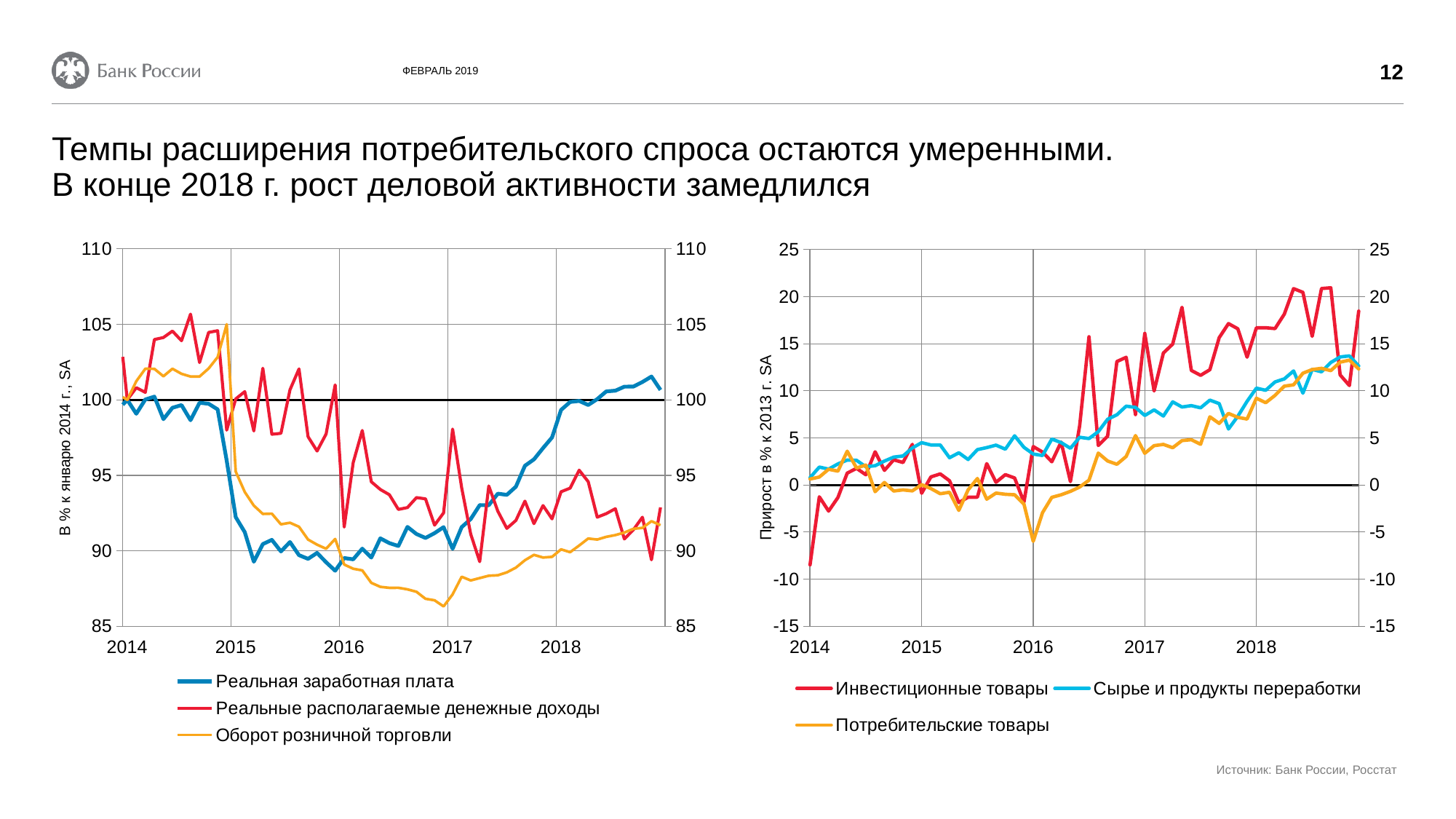
In the right chart, is the value for Сырье и продукты переработки at the end of 2018 greater or less than 10? greater In the left chart, at the end of 2018, which is higher: Реальная заработная плата or Реальные располагаемые денежные доходы? Реальная заработная плата In the left chart, is the value for Реальная заработная плата at the end of 2018 greater or less than 100? greater In the left chart, does Оборот розничной торговли rise or fall between 2015 and 2017? fall In the left chart, is the value for Оборот розничной торговли at the start of 2017 greater or less than 90? less In the right chart, at the start of 2017, which is higher: Инвестиционные товары or Потребительские товары? Инвестиционные товары How many series does the legend of the right chart list? 3 In the left chart, which series is shown in blue? Реальная заработная плата What kind of chart is the left chart on the slide? line chart What is the y-axis label of the right chart? Прирост в % к 2013 г., SA